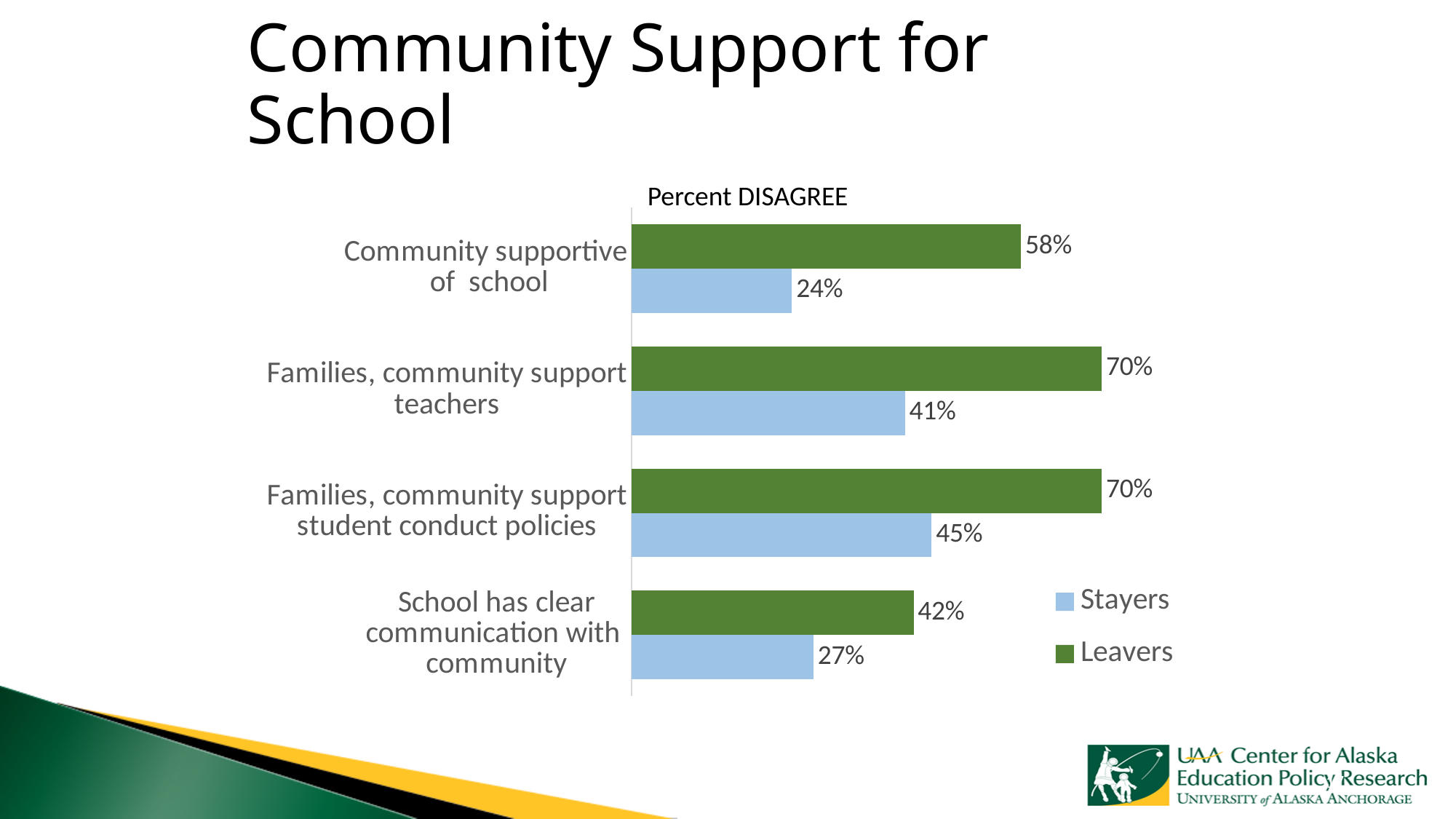
How many series does the legend list? 2 How many categories are shown on the chart? 4 What percent of Stayers disagree that the community is supportive of school? 24% What percent of Leavers disagree that the community is supportive of school? 58% What type of chart is shown on the slide? Bar chart What is the difference between the Leavers and Stayers values for 'Community supportive of school'? 34% For 'School has clear communication with community', which group has the larger value, Stayers or Leavers? Leavers What is the Stayers value for 'Families, community support teachers'? 41% What is the Leavers value for 'School has clear communication with community'? 42% Which category has the lowest Stayers value? Community supportive of school What is the difference between the Leavers and Stayers values for 'Families, community support student conduct policies'? 25% Which category has the lowest Leavers value? School has clear communication with community